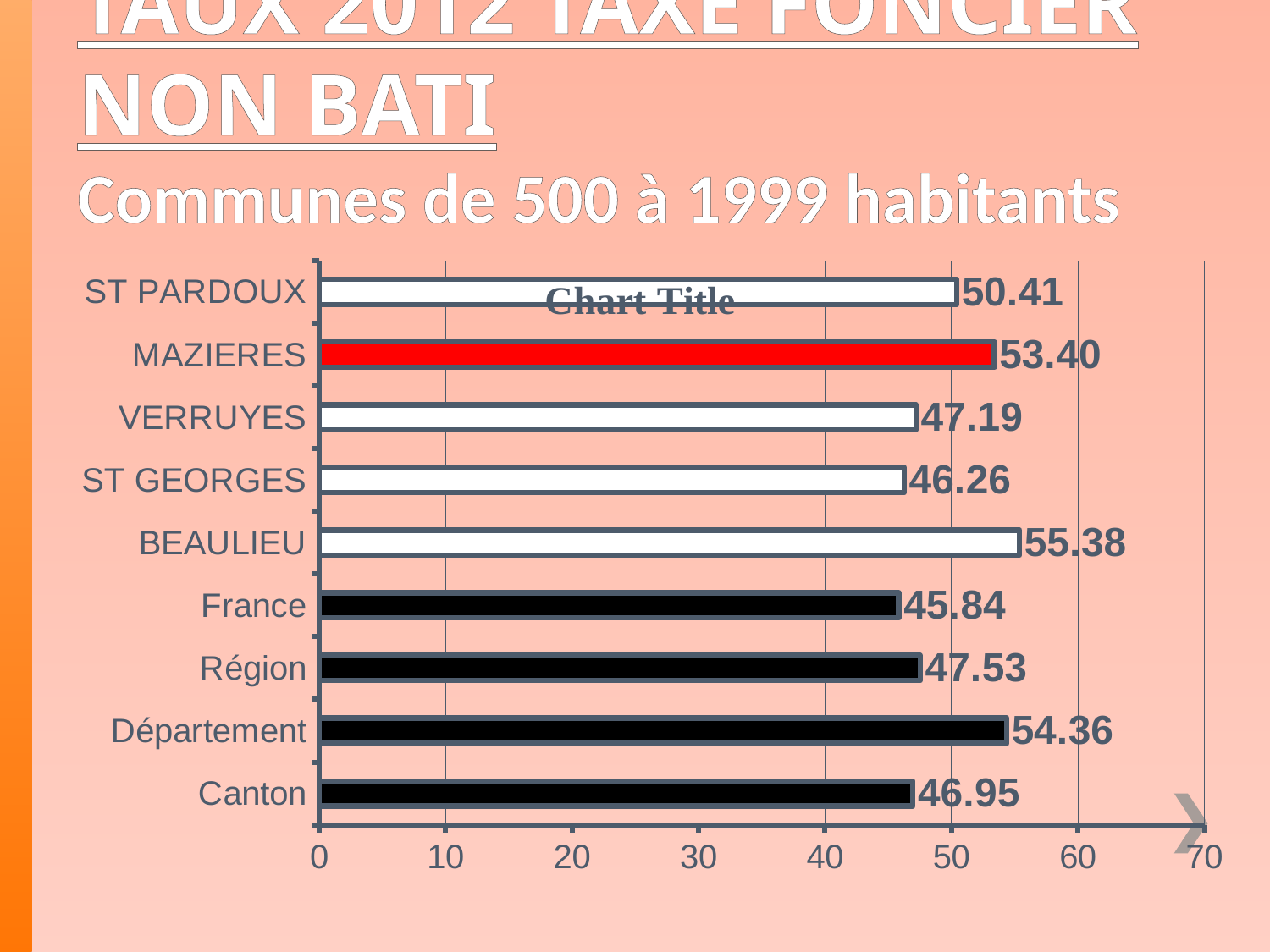
Which category has the lowest value? France What is the value for Département? 54.36 Which is larger, the value for Région or the value for Canton? Région What is the value for MAZIERES? 53.40 What is the difference between the values for MAZIERES and ST PARDOUX? 2.99 What kind of chart is shown on the slide? bar chart Is the value for VERRUYES greater or less than 50? less Which bar is coloured red? MAZIERES What is the difference between the values for BEAULIEU and ST GEORGES? 9.12 What is the value for France? 45.84 Which category has the highest value? BEAULIEU How many categories are shown in the chart? 9